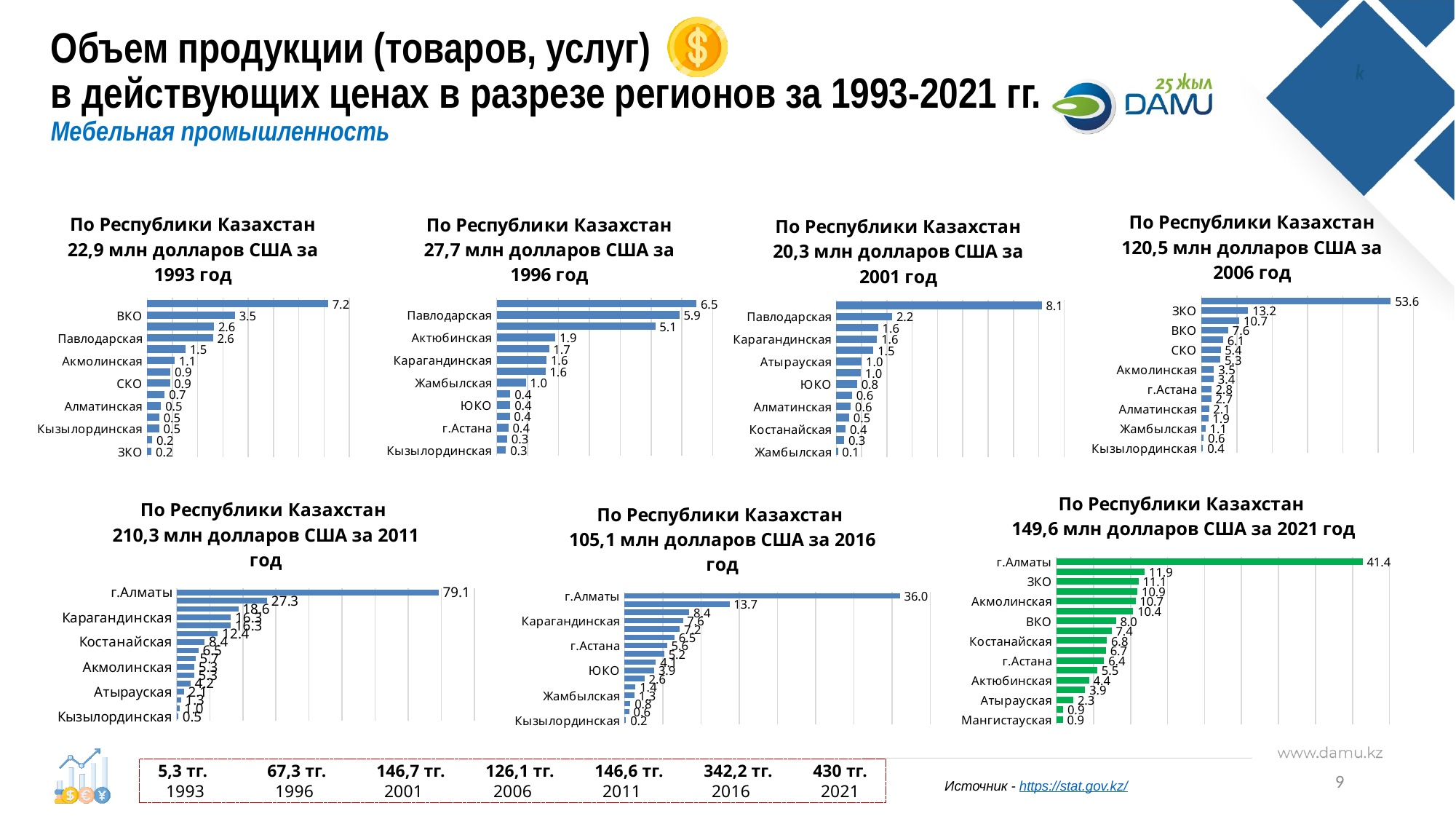
What kind of chart is the 1993 chart ("По Республики Казахстан 22,9 млн долларов США за 1993 год")? bar chart In the 2021 chart, which is larger, Акмолинская or Костанайская? Акмолинская In the 2021 chart, what is the difference between г.Алматы and ЗКО? 30.3 How many charts are on the slide? 7 In the 2006 chart, what is the difference between ВКО and СКО? 2.2 In the 2006 chart, what is the value for ЗКО? 13.2 In the 2016 chart, what is the value for г.Алматы? 36.0 In the 2001 chart, what is the value for Карагандинская? 1.6 In the 2011 chart, which region has the highest value? г.Алматы In the 1993 chart, what is the value for ВКО? 3.5 In the 1996 chart, what is the value for Павлодарская? 5.9